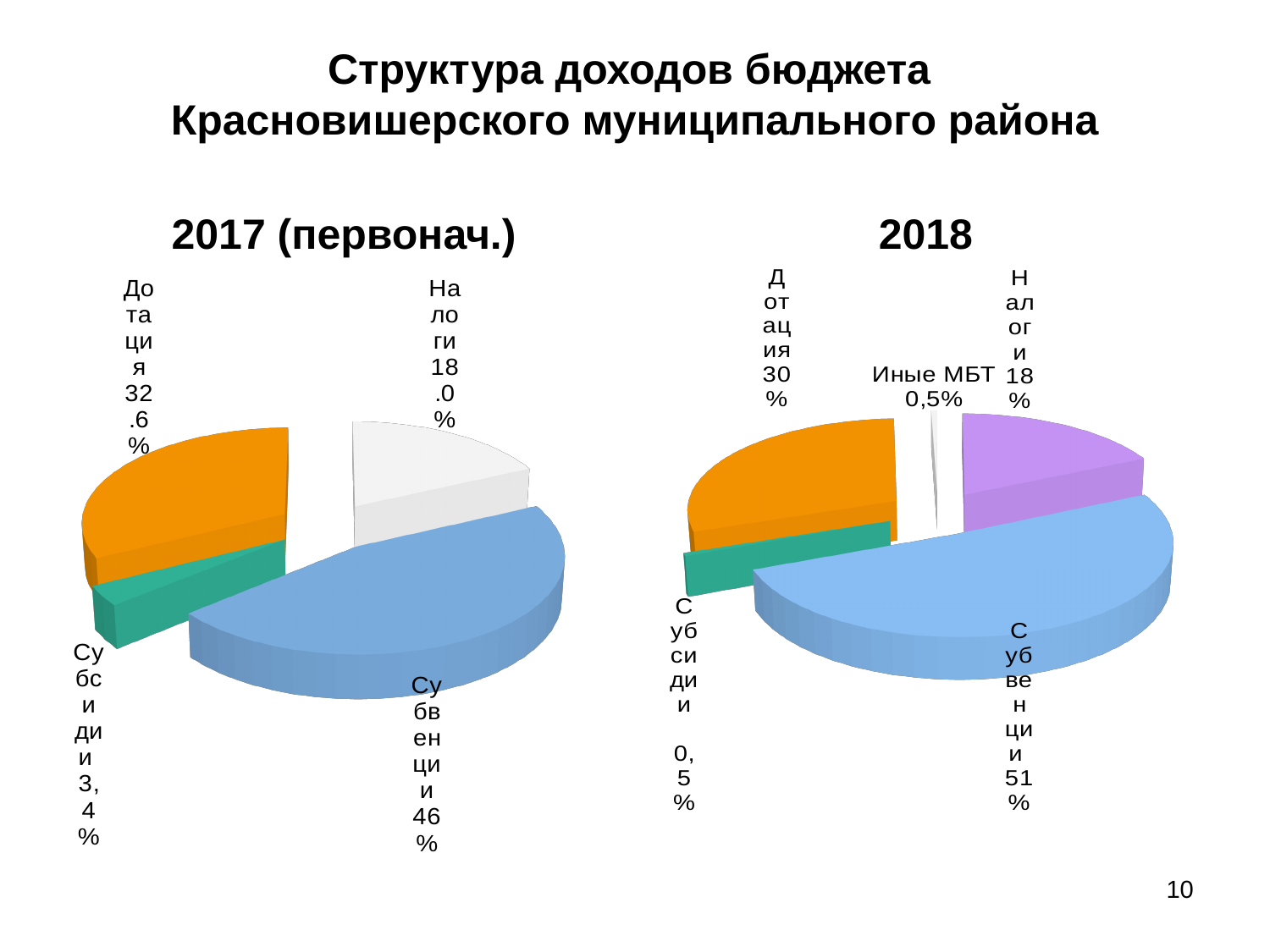
In the 2017 (первонач.) chart, what share is labelled for Субвенции? 46% In the 2018 chart, what share is labelled for Субвенции? 51% What type of chart is used for the 2017 (первонач.) data? pie chart In the 2017 (первонач.) chart, which category has the smallest share? Субсидии In the 2018 chart, what share is labelled for Иные МБТ? 0,5% How many slices does the 2017 (первонач.) pie chart have? 4 In the 2017 (первонач.) chart, what share is labelled for Налоги? 18.0% In the 2018 chart, what is the difference between the shares of Субвенции and Дотация? 21% In the 2018 chart, which category has the largest share? Субвенции How many slices does the 2018 pie chart have? 5 Which is larger: the share of Дотация in the 2017 (первонач.) chart or in the 2018 chart? 2017 (первонач.) In the 2017 (первонач.) chart, what share is labelled for Дотация? 32.6%